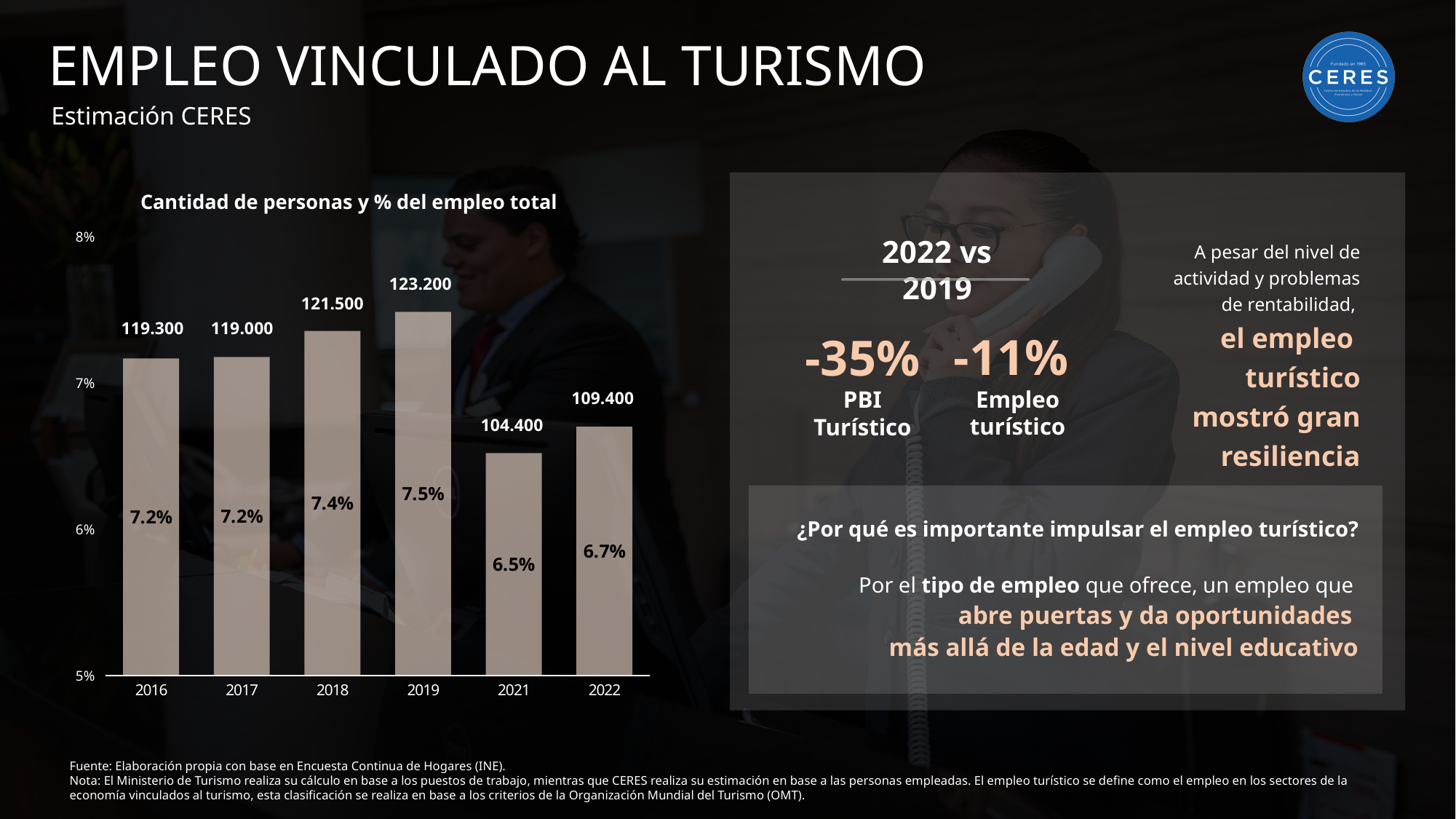
Is the bar for 2021 greater or less than 7% on the axis? less Which year has a higher number of persons, 2018 or 2022? 2018 Which year has the highest number of persons employed in tourism? 2019 What is the difference in number of persons between 2019 and 2021? 18.800 What is the number of persons shown for 2019? 123.200 Do the percentage values rise or fall from 2016 to 2019? rise Which year has the lowest percentage of total employment? 2021 How many years are shown on the x axis of the chart? 6 What kind of chart is shown on the slide? bar chart What is the title of the chart? Cantidad de personas y % del empleo total What is the number of persons shown for 2022? 109.400 What percentage of total employment is shown for 2021? 6.5%